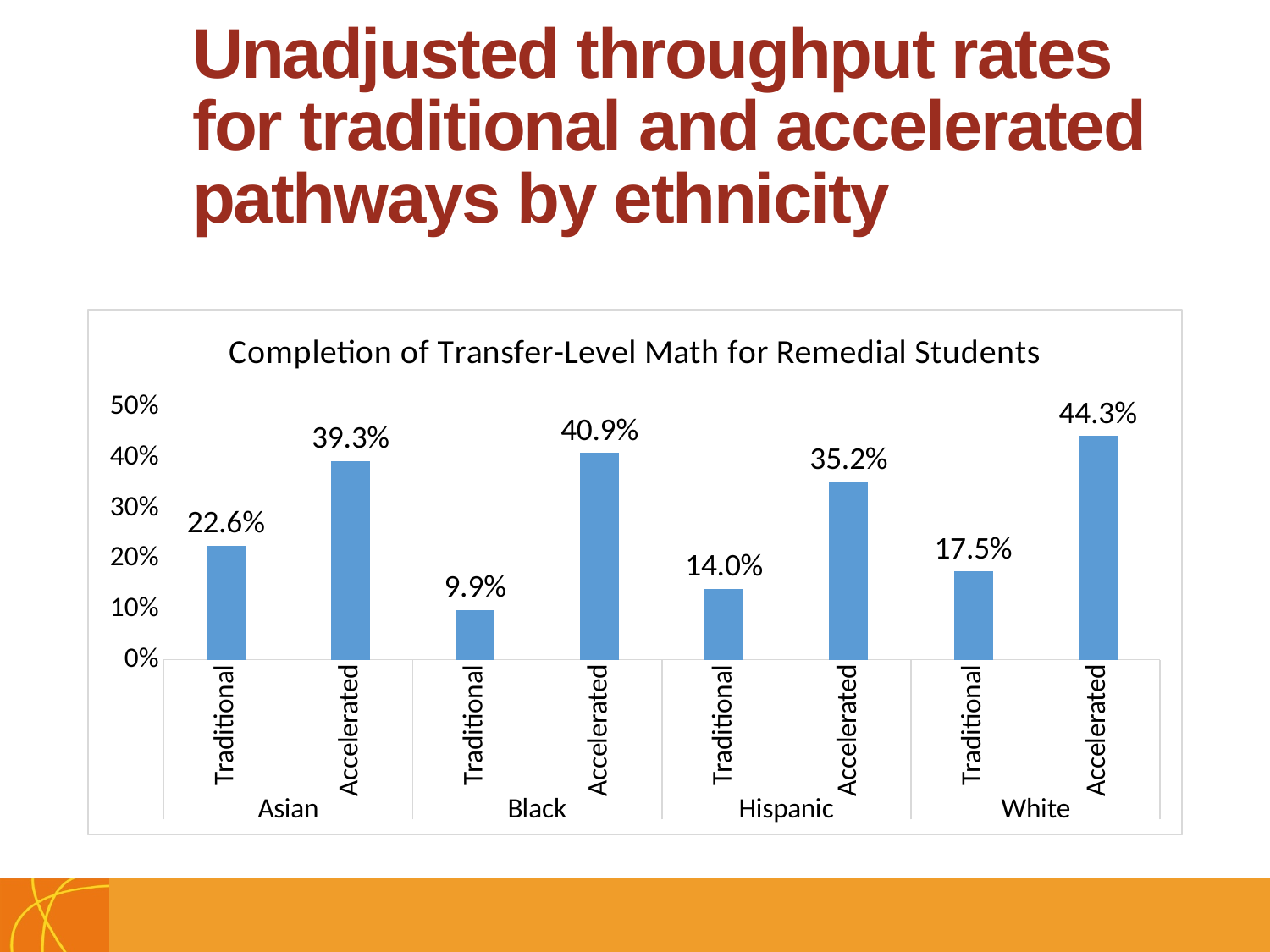
What is the completion rate for Asian students in the Accelerated pathway? 39.3% Which is larger: the Traditional rate for Asian students or the Traditional rate for White students? Asian Traditional Which bar has the lowest completion rate? Black Traditional What type of chart is shown on the slide? Bar chart How many bars are plotted in the chart? 8 What is the completion rate for White students in the Accelerated pathway? 44.3% What is the difference between the Accelerated and Traditional completion rates for Black students? 31.0% What is the completion rate for Black students in the Traditional pathway? 9.9% Which bar has the highest completion rate? White Accelerated What is the completion rate for Hispanic students in the Traditional pathway? 14.0% What is the difference between the Accelerated and Traditional completion rates for White students? 26.8% What is the title of the chart? Completion of Transfer-Level Math for Remedial Students